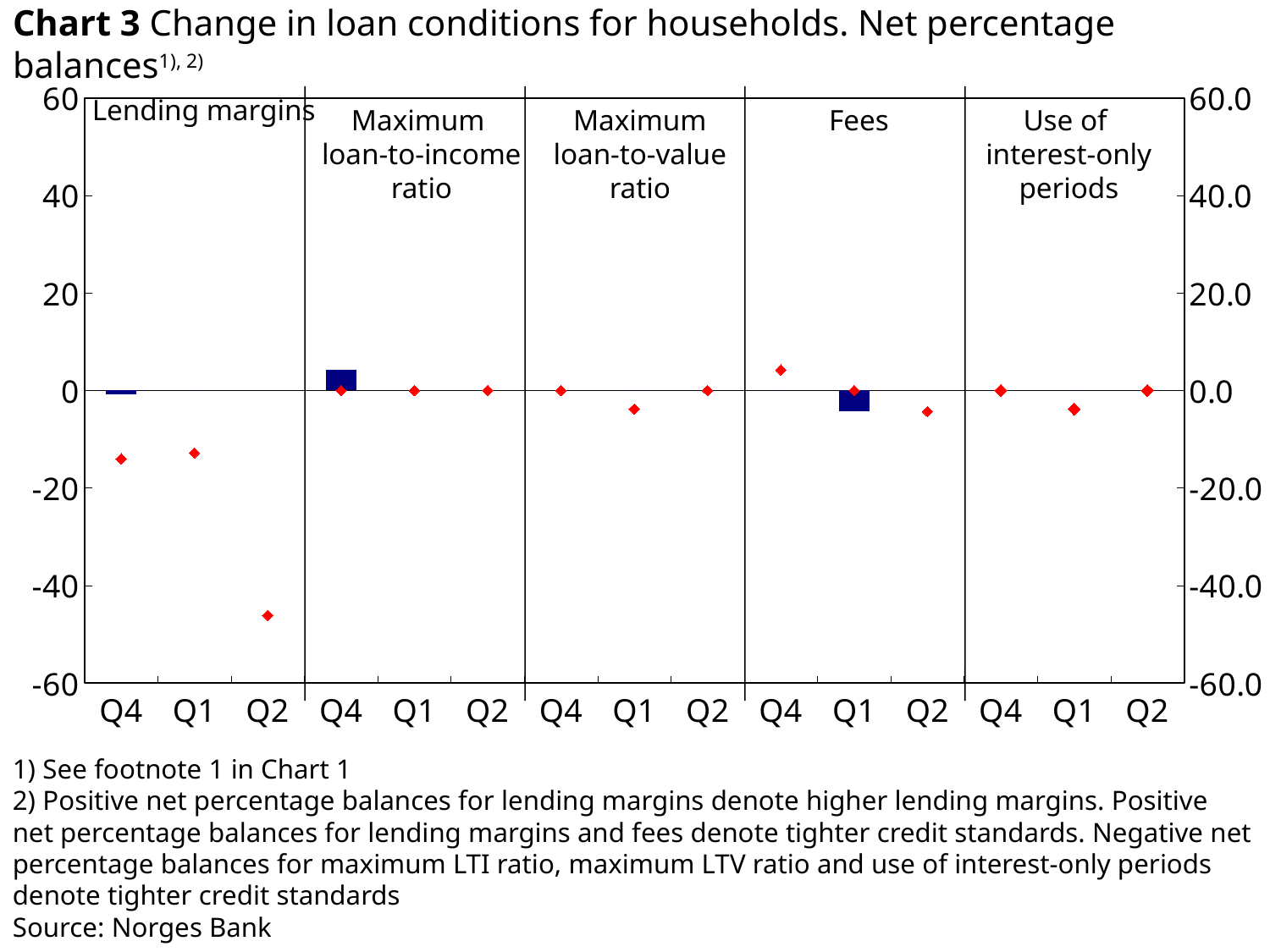
Which panel contains the lowest marker on the whole chart? Lending margins What kind of chart is shown on the slide? bar chart with diamond markers Is the Q2 marker in the Lending margins panel greater or less than -40? less In the Lending margins panel, is the Q1 marker or the Q2 marker higher? Q1 How many loan-condition panels does the chart have? 5 Is the Q4 marker in the Fees panel greater or less than 0? greater In the Lending margins panel, is the Q2 marker higher or lower than the Q4 marker? lower How many quarters are shown in each panel of the chart? 3 What is the source given for the chart? Norges Bank What is the title of the chart? Chart 3 Change in loan conditions for households. Net percentage balances Is the Q4 marker in the Lending margins panel greater or less than -20? greater In the Lending margins panel, which quarter has the lowest marker? Q2